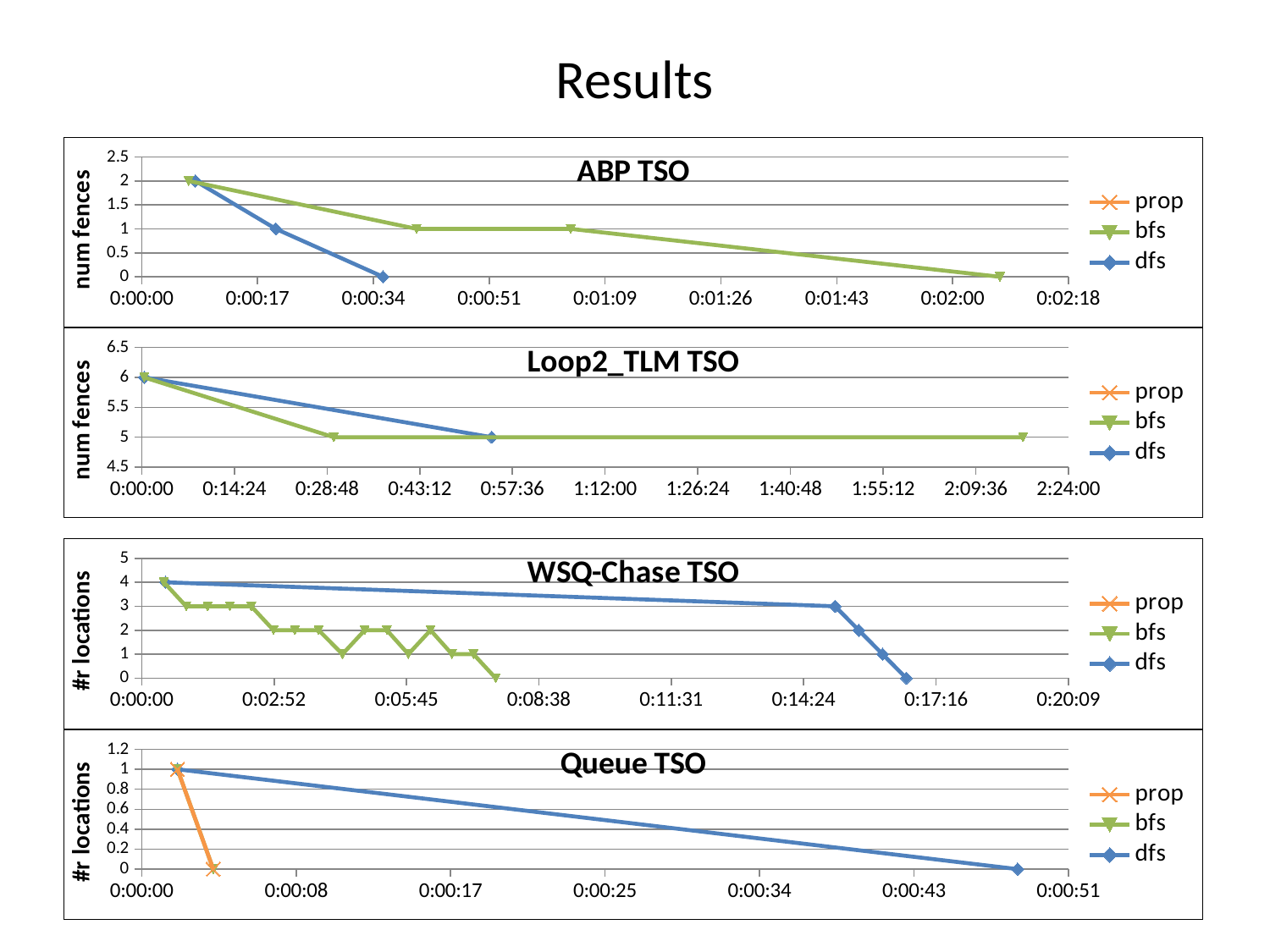
What kind of chart is the ABP TSO chart? line chart In the ABP TSO chart, what is the difference between the starting and final values of the bfs series? 2 In the ABP TSO chart, what is the starting value of the bfs series? 2 In the ABP TSO chart, which series reaches 0 fences at an earlier time, bfs or dfs? dfs How many series does the legend of the Queue TSO chart list? 3 In the Loop2_TLM TSO chart, is the starting value of the dfs series greater or less than 5.5? greater In the WSQ-Chase TSO chart, what is the starting value of the dfs series? 4 What is the y-axis label of the Queue TSO chart? #r locations How many charts are shown on the slide? 4 In the Loop2_TLM TSO chart, what is the final value of the bfs series? 5 In the Loop2_TLM TSO chart, what is the starting value of the bfs series? 6 In the WSQ-Chase TSO chart, does the bfs series rise or fall along the x axis? falls